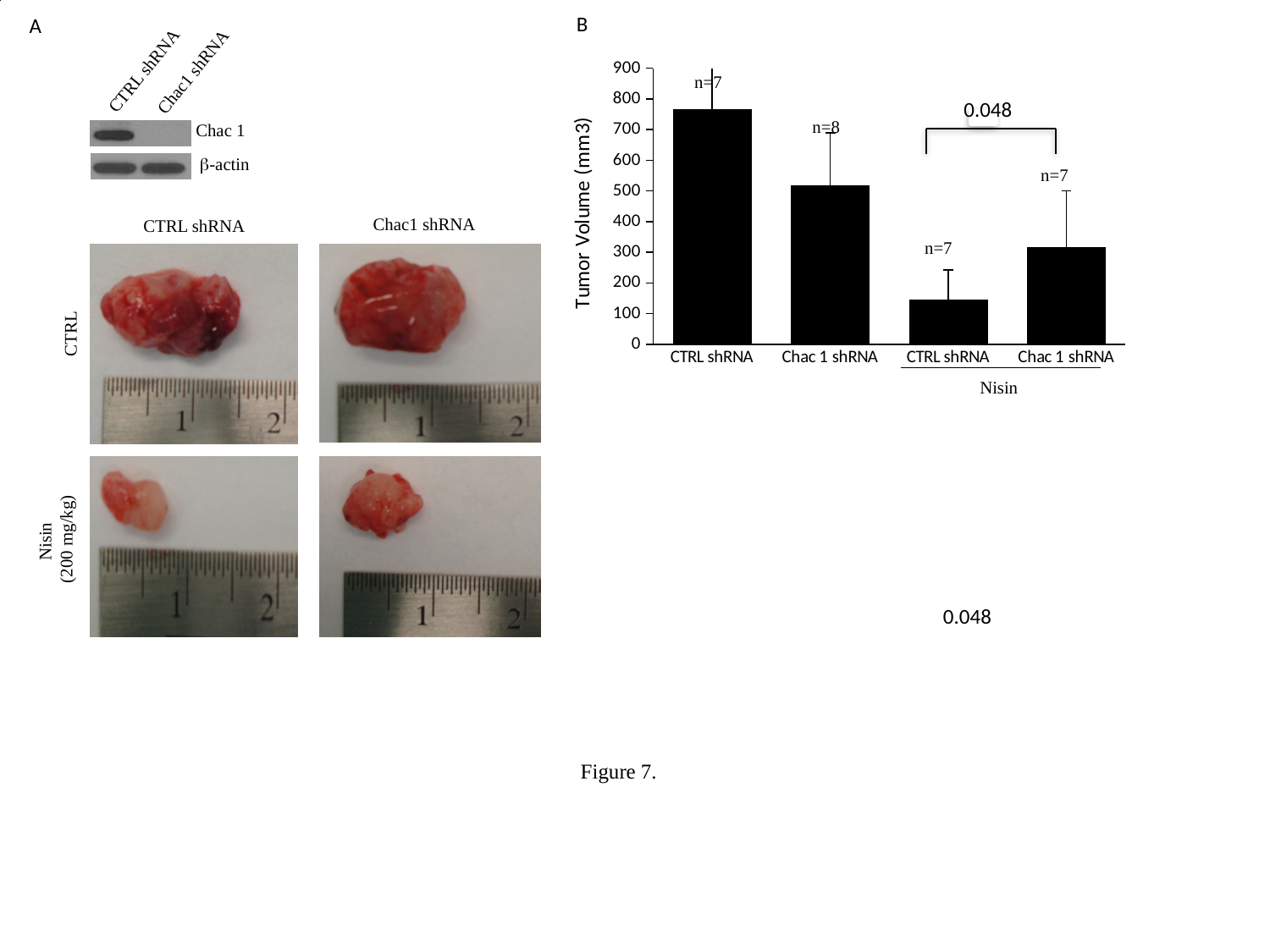
In the panel B chart, under Nisin treatment, which has the larger tumor volume: CTRL shRNA or Chac 1 shRNA? Chac 1 shRNA In the panel B chart, is the tumor volume for Chac 1 shRNA under Nisin greater or less than 400? less In the panel B chart, what sample size (n) is shown above the Chac 1 shRNA bar without Nisin? n=8 In the panel B chart, which bar has the lowest tumor volume? CTRL shRNA (Nisin) In the panel B chart, is the tumor volume for Chac 1 shRNA without Nisin greater or less than 600? less What kind of chart is shown in panel B? bar chart In the panel B chart, is the tumor volume for CTRL shRNA under Nisin greater or less than 200? less How many bars are plotted in the panel B chart? 4 In the panel B chart, which bar has the highest tumor volume? CTRL shRNA (without Nisin) What is the y-axis label of the panel B chart? Tumor Volume (mm3) In the panel B chart, without Nisin, which has the larger tumor volume: CTRL shRNA or Chac 1 shRNA? CTRL shRNA